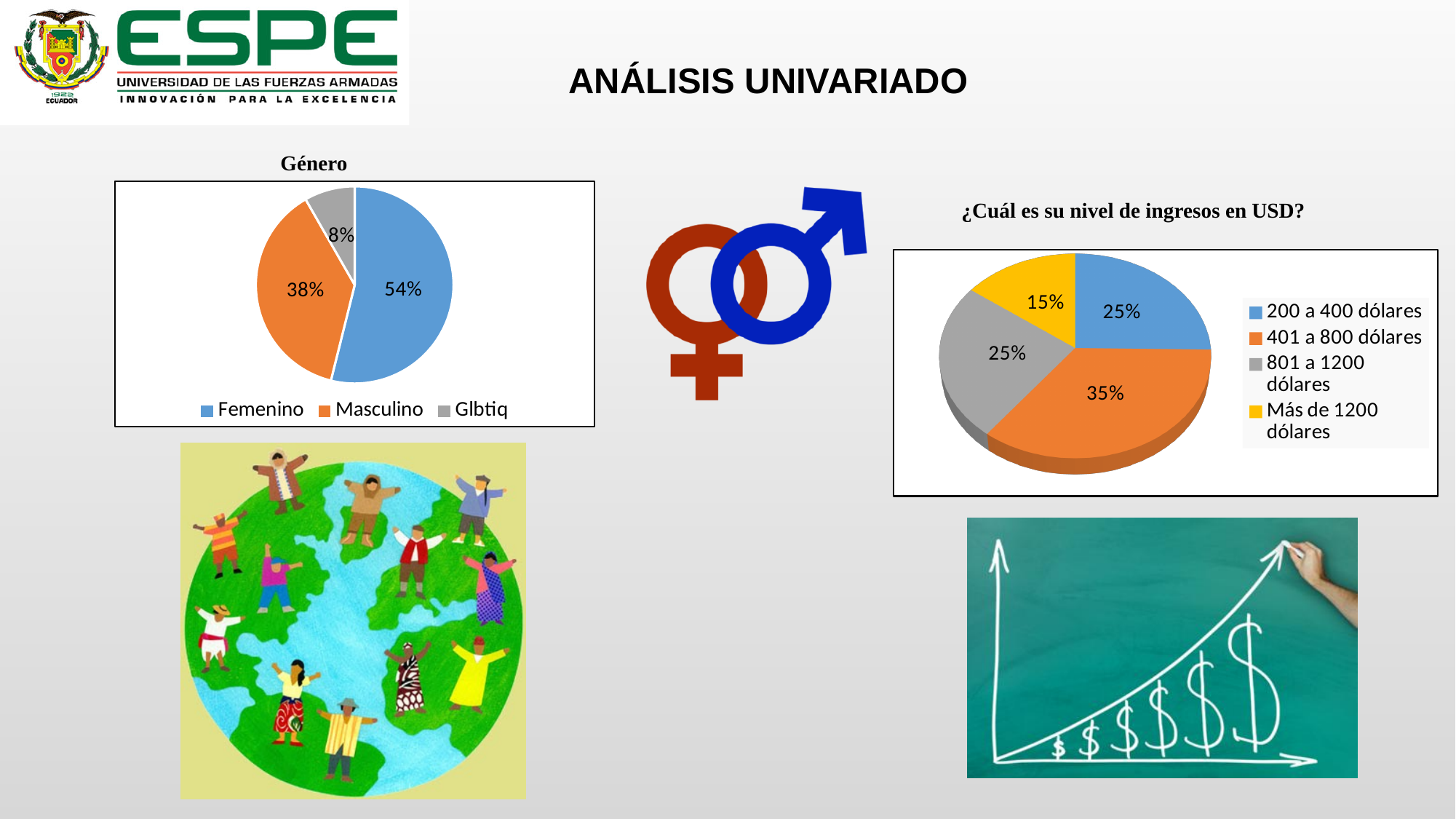
In the 'Género' pie chart, which category has the largest share? Femenino In the 'Género' pie chart, how many categories are shown? 3 In the 'Género' pie chart, what share is Glbtiq? 8% In the '¿Cuál es su nivel de ingresos en USD?' pie chart, which category has the largest share? 401 a 800 dólares What type of chart is the '¿Cuál es su nivel de ingresos en USD?' chart? Pie chart In the 'Género' pie chart, what share is Masculino? 38% In the 'Género' pie chart, what is the difference in percentage points between Femenino and Masculino? 16 In the '¿Cuál es su nivel de ingresos en USD?' pie chart, what share is '401 a 800 dólares'? 35% In the '¿Cuál es su nivel de ingresos en USD?' pie chart, what share is 'Más de 1200 dólares'? 15% In the 'Género' pie chart, which category has the smallest share? Glbtiq In the 'Género' pie chart, what share is Femenino? 54% In the '¿Cuál es su nivel de ingresos en USD?' pie chart, how many categories does the legend list? 4